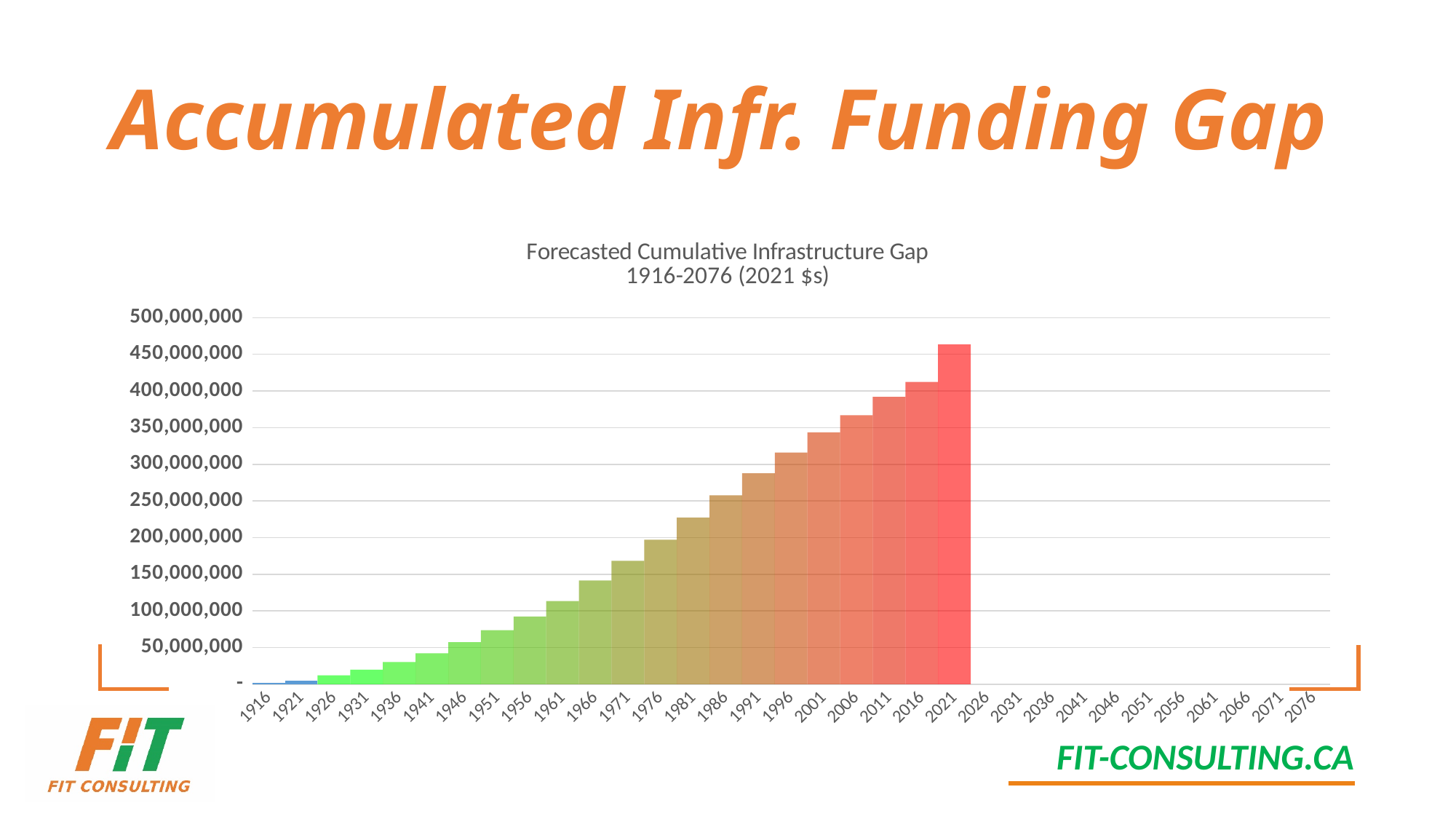
Is the value for 1951 greater or less than 50,000,000? greater What kind of chart is shown on the slide? bar chart What is the title of the chart? Forecasted Cumulative Infrastructure Gap 1916-2076 (2021 $s) How many year labels are shown on the x axis? 33 Which year has the tallest bar? 2021 Is the value for 2006 greater or less than 350,000,000? greater Is the value for 1971 greater or less than 150,000,000? greater Do the bar values rise or fall from 1916 to 2021? rise Which year has the larger value, 1966 or 2011? 2011 Which year has the shortest bar? 1916